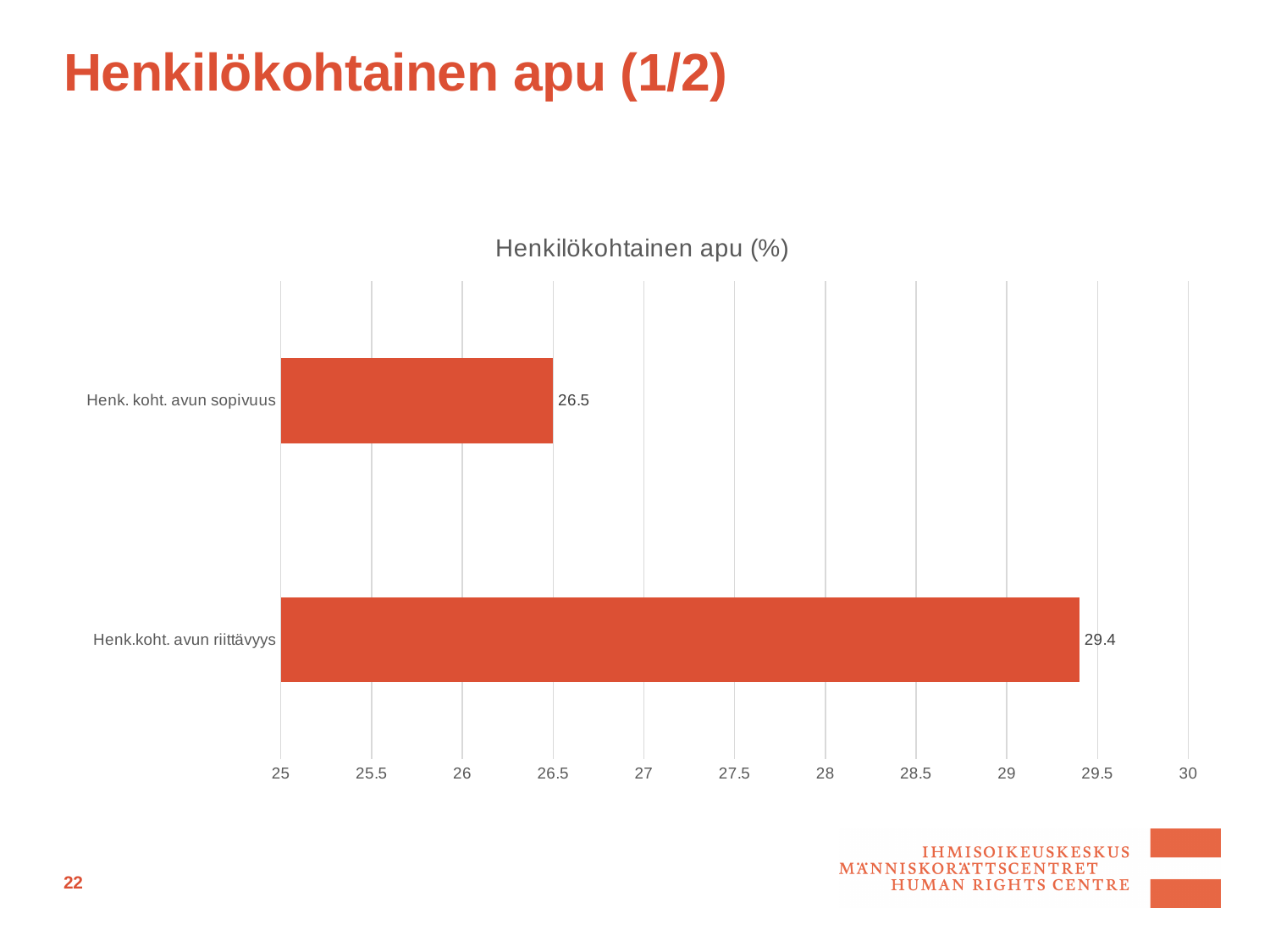
Which category has the lowest value? Henk. koht. avun sopivuus What is the title of the chart? Henkilökohtainen apu (%) Which is larger, the value for Henk. koht. avun sopivuus or the value for Henk.koht. avun riittävyys? Henk.koht. avun riittävyys What is the value for Henk. koht. avun sopivuus? 26.5 What is the maximum value shown on the x axis? 30 How many categories are shown in the chart? 2 What kind of chart is shown on the slide? bar chart What is the difference between the values for Henk.koht. avun riittävyys and Henk. koht. avun sopivuus? 2.9 What is the value for Henk.koht. avun riittävyys? 29.4 Which category has the highest value? Henk.koht. avun riittävyys Is the value for Henk.koht. avun riittävyys greater or less than 28? greater Is the value for Henk. koht. avun sopivuus greater or less than 27? less